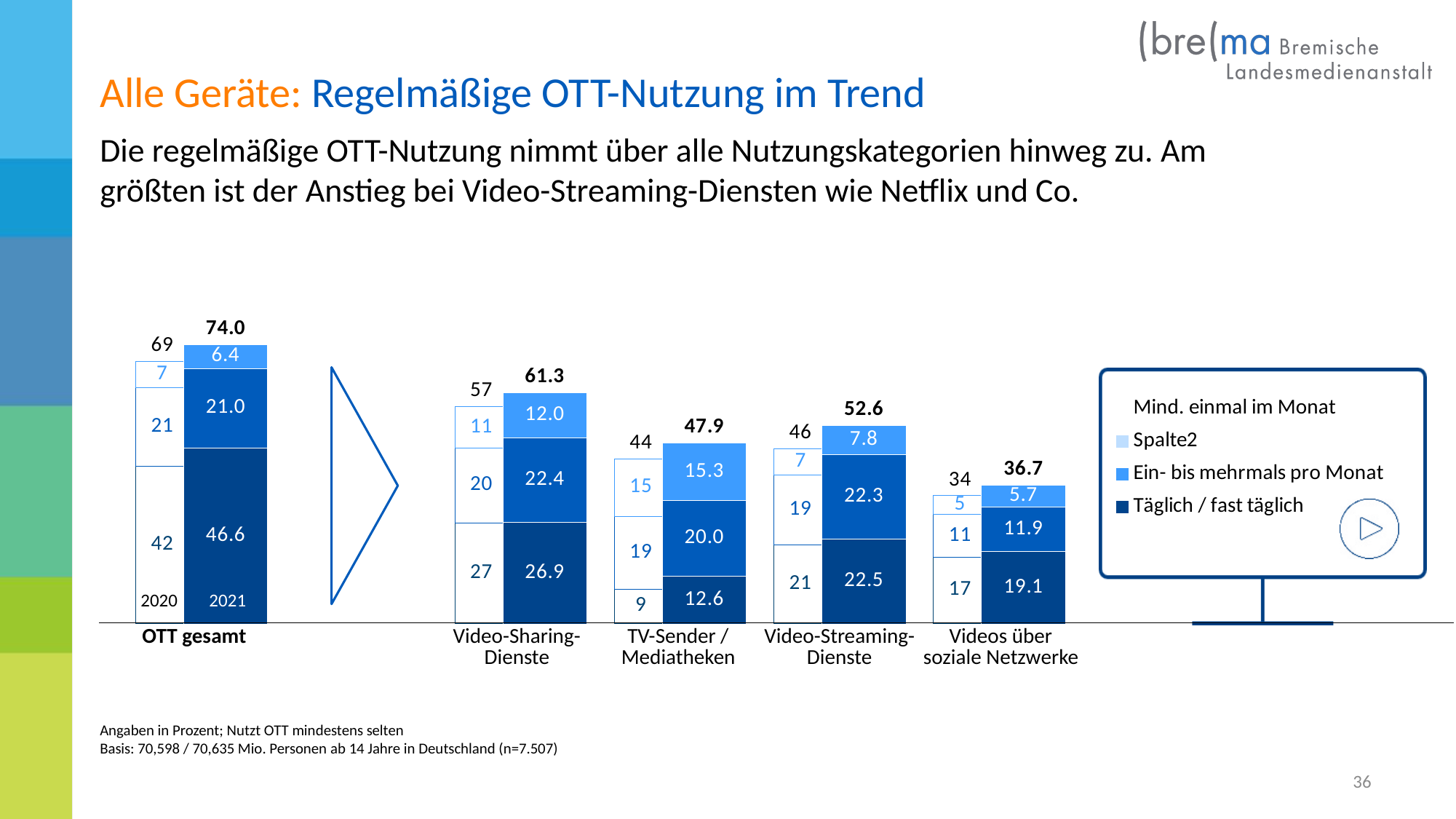
What is the difference between the 2021 total (52.6) and the 2020 total (46) for Video-Streaming-Dienste? 6.6 Which category has the lowest 2021 total? Videos über soziale Netzwerke What is the 'Ein- bis mehrmals pro Monat' value in the 2021 bar for TV-Sender / Mediatheken? 15.3 Do the totals rise or fall from 2020 to 2021 across the categories? Rise What is the 'Täglich / fast täglich' value in the 2021 bar for OTT gesamt? 46.6 What kind of chart is shown on the slide? Stacked bar chart Which category has the highest 2021 total? OTT gesamt What is the total value of the 2020 bar for TV-Sender / Mediatheken? 44 What is the total value of the 2021 bar for Video-Streaming-Dienste? 52.6 In 2021, which has the larger 'Täglich / fast täglich' value: Video-Sharing-Dienste or Video-Streaming-Dienste? Video-Sharing-Dienste How many usage categories are shown on the x axis of the chart? 5 By how much did the OTT gesamt total increase from 2020 (69) to 2021 (74.0)? 5.0